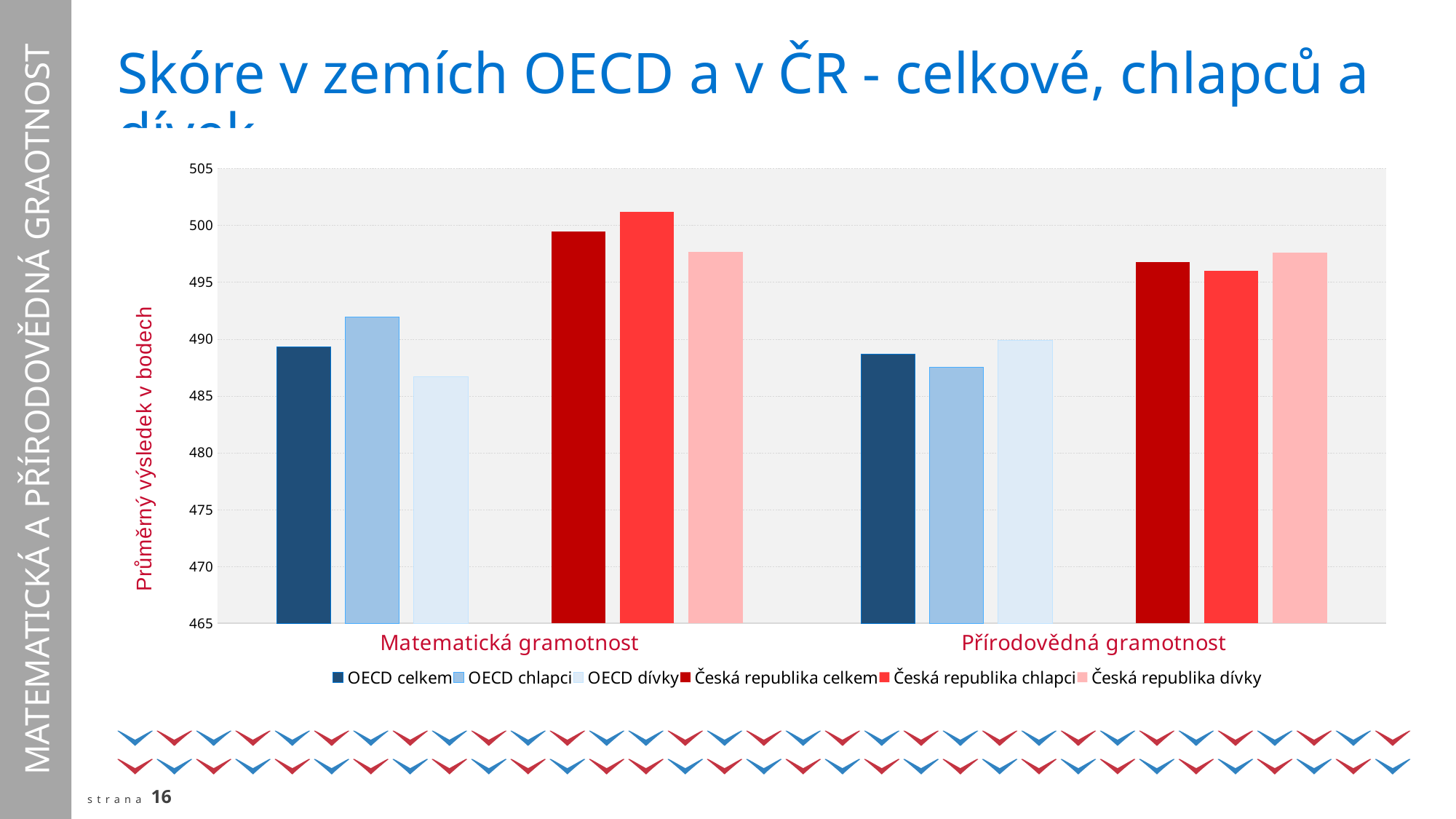
Is the value for OECD chlapci in Matematická gramotnost greater or less than 490? greater What kind of chart is shown on the slide? bar chart How many categories are shown on the x axis? 2 What is the title of the vertical axis? Průměrný výsledek v bodech How many series does the legend list? 6 In the Matematická gramotnost category, which series has the lowest bar? OECD dívky Is the value for OECD chlapci in Přírodovědná gramotnost greater or less than 490? less For Česká republika celkem, which category has the larger value: Matematická gramotnost or Přírodovědná gramotnost? Matematická gramotnost Is the value for Česká republika celkem in Matematická gramotnost greater or less than 495? greater In the Matematická gramotnost category, which series has the highest bar? Česká republika chlapci In Přírodovědná gramotnost, which is larger: OECD chlapci or OECD dívky? OECD dívky